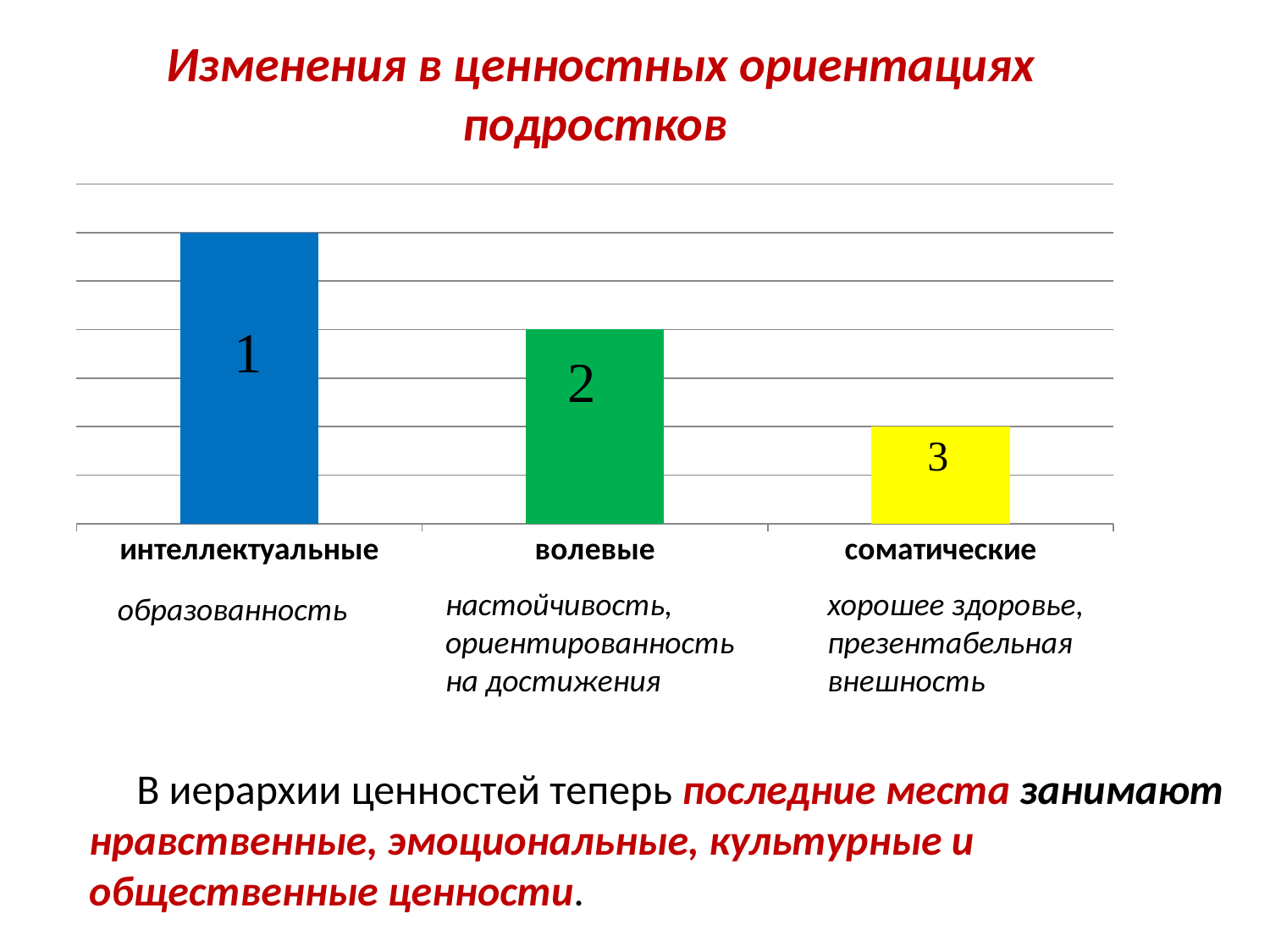
What colour is the bar for соматические? yellow Which bar is taller: волевые or соматические? волевые Which bar is taller: интеллектуальные or волевые? интеллектуальные How many categories are shown on the x axis of the chart? 3 What number is printed on the bar for интеллектуальные? 1 Do the bar heights rise or fall from left to right across the x axis? fall What kind of chart is shown on the slide? bar chart Which category has the shortest bar in the chart? соматические What number is printed on the bar for волевые? 2 What number is printed on the bar for соматические? 3 What is the title of the slide containing the chart? Изменения в ценностных ориентациях подростков Which category has the tallest bar in the chart? интеллектуальные